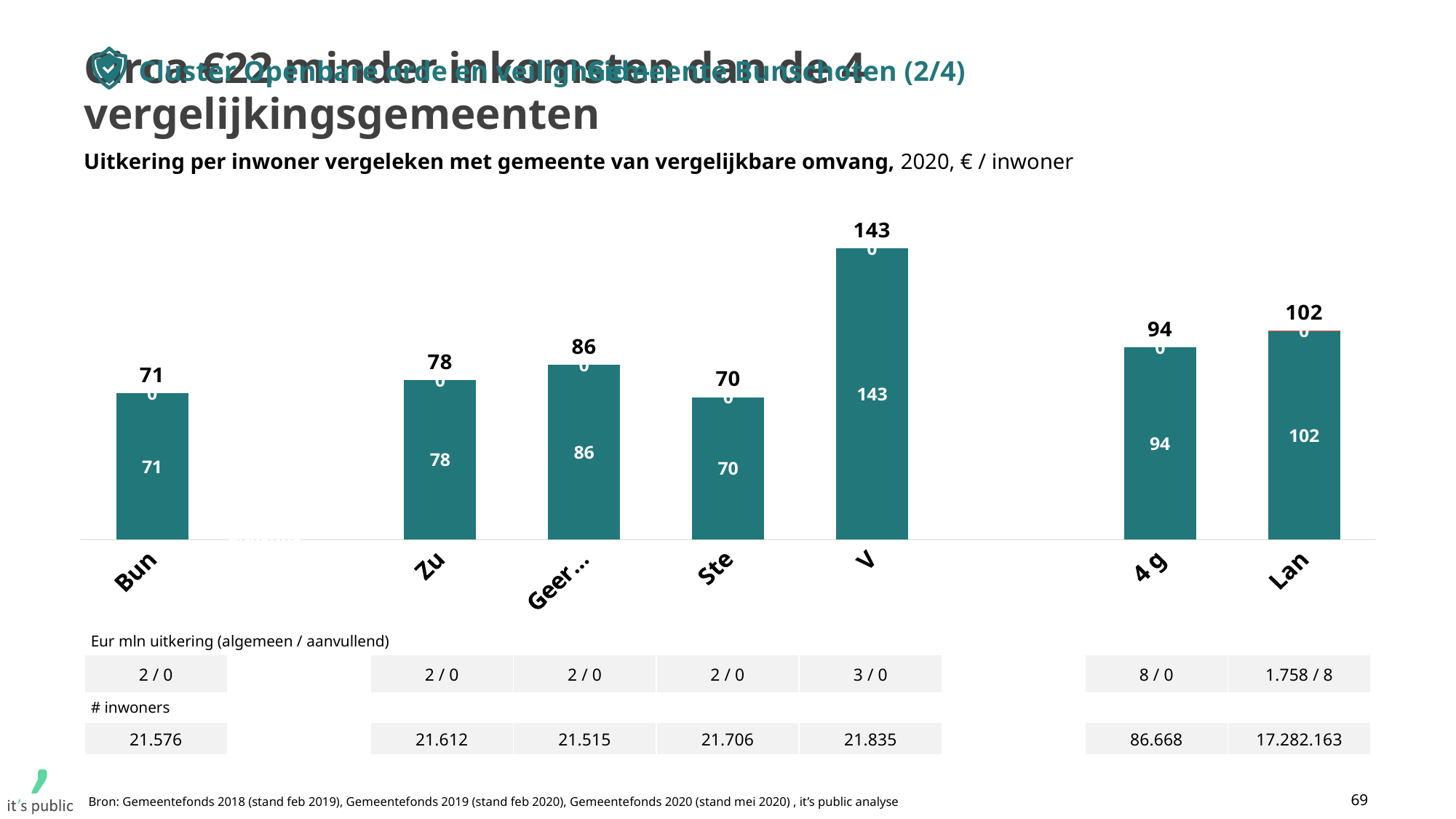
Which category has the highest value? V What is the value for V? 143 What kind of chart is shown on the slide? bar chart What unit is given in the chart subtitle for the plotted values? € / inwoner Which is larger, the value for Zu or the value for Geer…? Geer… What is the value for Bun? 71 How many bars are shown in the chart? 7 What is the value for Lan? 102 Which category has the lowest value? Ste What is the difference between the values for Lan and 4 g? 8 What is the difference between the values for V and Bun? 72 What is the value for Ste? 70